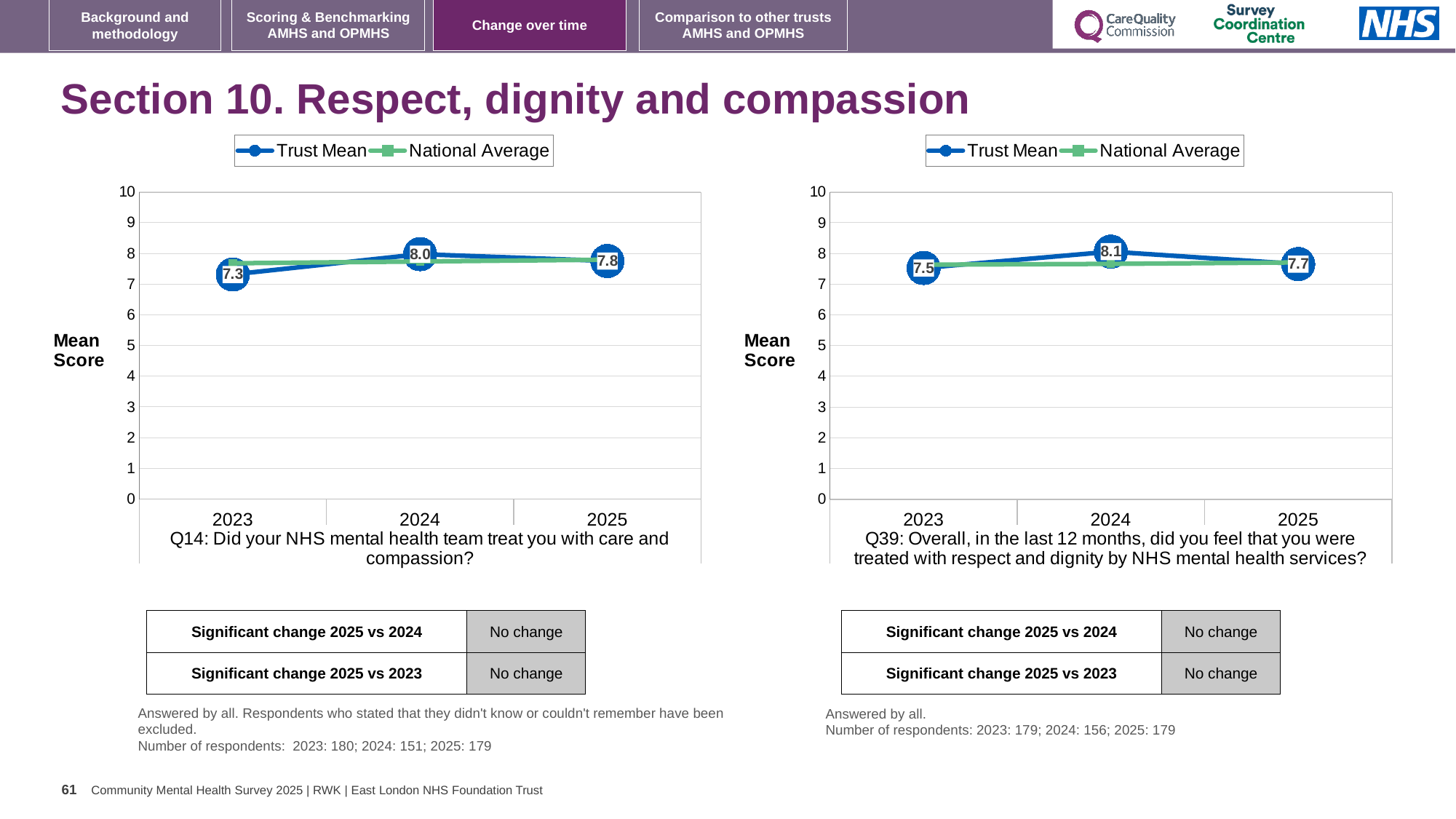
In the left chart (Q14), what is the Trust Mean for 2024? 8.0 In the left chart (Q14), what is the difference between the Trust Mean for 2024 and the Trust Mean for 2023? 0.7 In the right chart (Q39), which is larger: the Trust Mean for 2024 or the Trust Mean for 2025? 2024 What kind of chart is the right chart (Q39)? Line chart In the right chart (Q39), what is the Trust Mean for 2023? 7.5 In the left chart (Q14), is the National Average for 2023 greater or less than 5? greater In the right chart (Q39: Overall, in the last 12 months, did you feel that you were treated with respect and dignity by NHS mental health services?), what is the Trust Mean for 2025? 7.7 How many series does the legend of the left chart (Q14) list? 2 In the left chart (Q14: Did your NHS mental health team treat you with care and compassion?), what is the Trust Mean for 2023? 7.3 How many years are plotted on the x axis of the right chart (Q39)? 3 In the right chart (Q39), which year has the lowest Trust Mean? 2023 In the left chart (Q14), which year has the highest Trust Mean? 2024